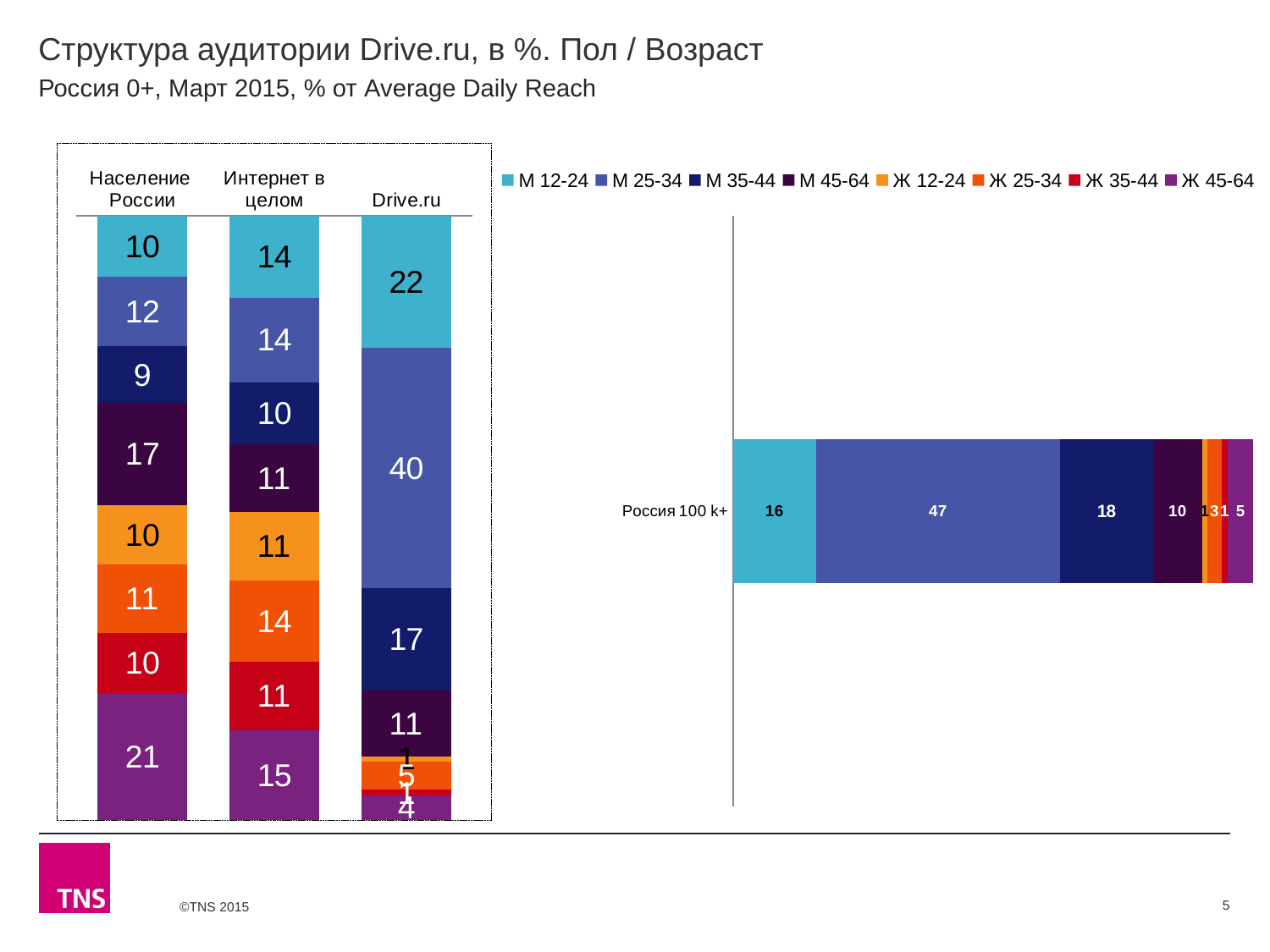
In the left chart, what is the value of the М 25-34 segment for Drive.ru? 40 In the left chart, which bar has the largest М 25-34 segment? Drive.ru In the left chart, what is the value of the Ж 45-64 segment for Население России? 21 How many series does the legend list? 8 How many bars are shown in the left chart? 3 In the left chart, what is the difference between the М 12-24 values for Drive.ru and Население России? 12 In the left chart, which is larger: the Ж 45-64 segment for Население России or for Интернет в целом? Население России What kind of chart is the right chart? Stacked bar chart In the left chart, what is the value of the М 12-24 segment for Интернет в целом? 14 In the left chart, what is the value of the М 35-44 segment for Drive.ru? 17 In the right chart, what is the value of the М 35-44 segment for Россия 100 k+? 18 In the right chart, what is the value of the М 25-34 segment for Россия 100 k+? 47